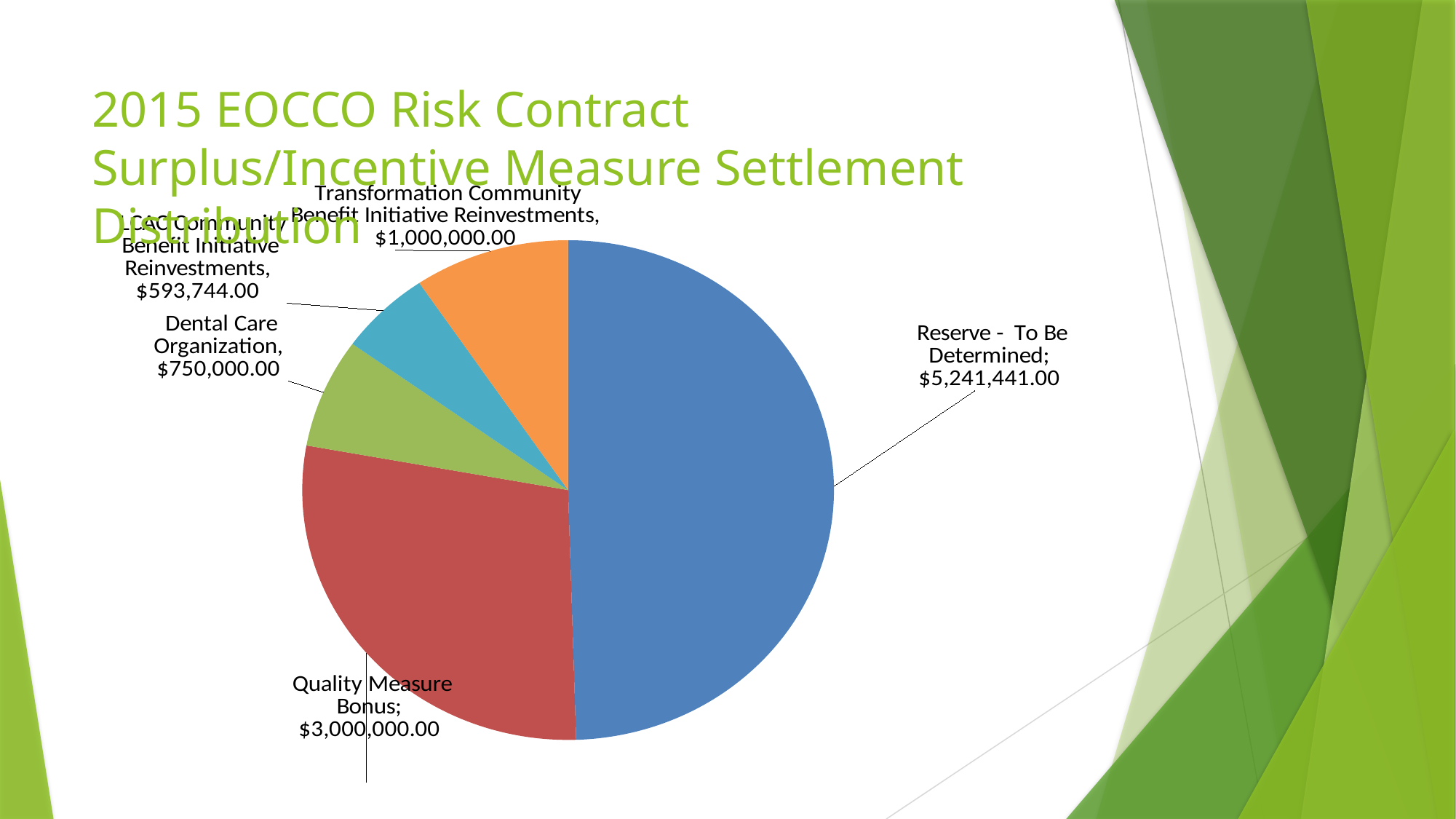
How many slices does the pie chart have? 5 What colour is the Quality Measure Bonus slice? red What is the value for Quality Measure Bonus? $3,000,000.00 Which is larger, Dental Care Organization or Transformation Community Benefit Initiative Reinvestments? Transformation Community Benefit Initiative Reinvestments What is the smallest value shown on the pie chart? $593,744.00 What kind of chart is shown on the slide? pie chart What is the difference between Reserve - To Be Determined and Quality Measure Bonus? $2,241,441.00 What is the value for Reserve - To Be Determined? $5,241,441.00 What is the value for Dental Care Organization? $750,000.00 What is the difference between Transformation Community Benefit Initiative Reinvestments and Dental Care Organization? $250,000.00 Which category has the largest slice of the pie? Reserve - To Be Determined What is the value for Transformation Community Benefit Initiative Reinvestments? $1,000,000.00